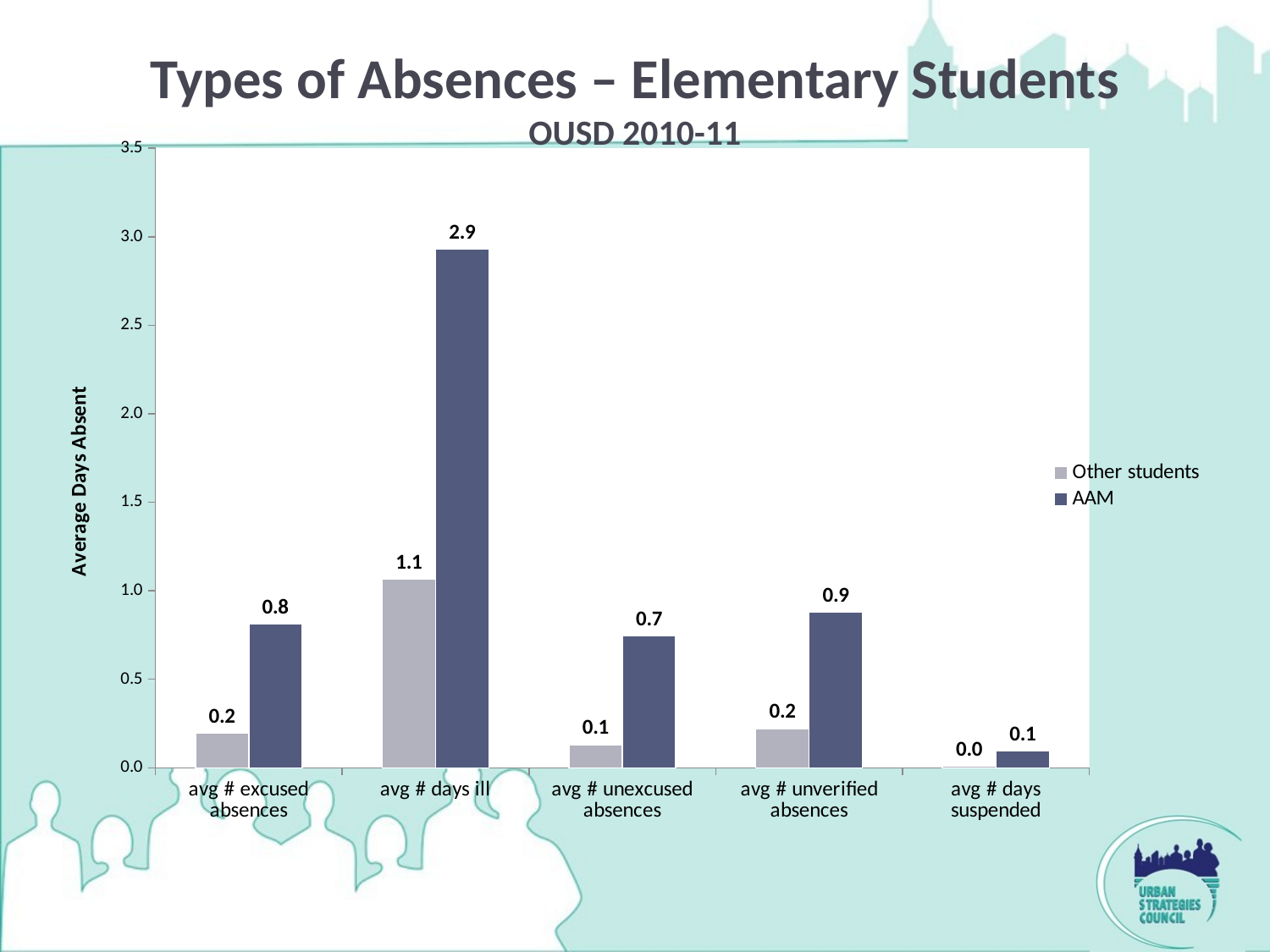
What is the value for AAM for avg # days ill? 2.9 Which category has the lowest value for Other students? avg # days suspended What is the value for Other students for avg # days suspended? 0.0 What kind of chart is shown on the slide? bar chart How many categories are shown on the x axis? 5 How many series does the legend list? 2 What is the value for AAM for avg # unverified absences? 0.9 Is the value for Other students for avg # days ill greater or less than 1.0? greater What is the difference between the AAM and Other students values for avg # days ill? 1.8 Which is larger for avg # unexcused absences: the AAM value or the Other students value? AAM Which category has the highest value for AAM? avg # days ill What is the value for Other students for avg # excused absences? 0.2